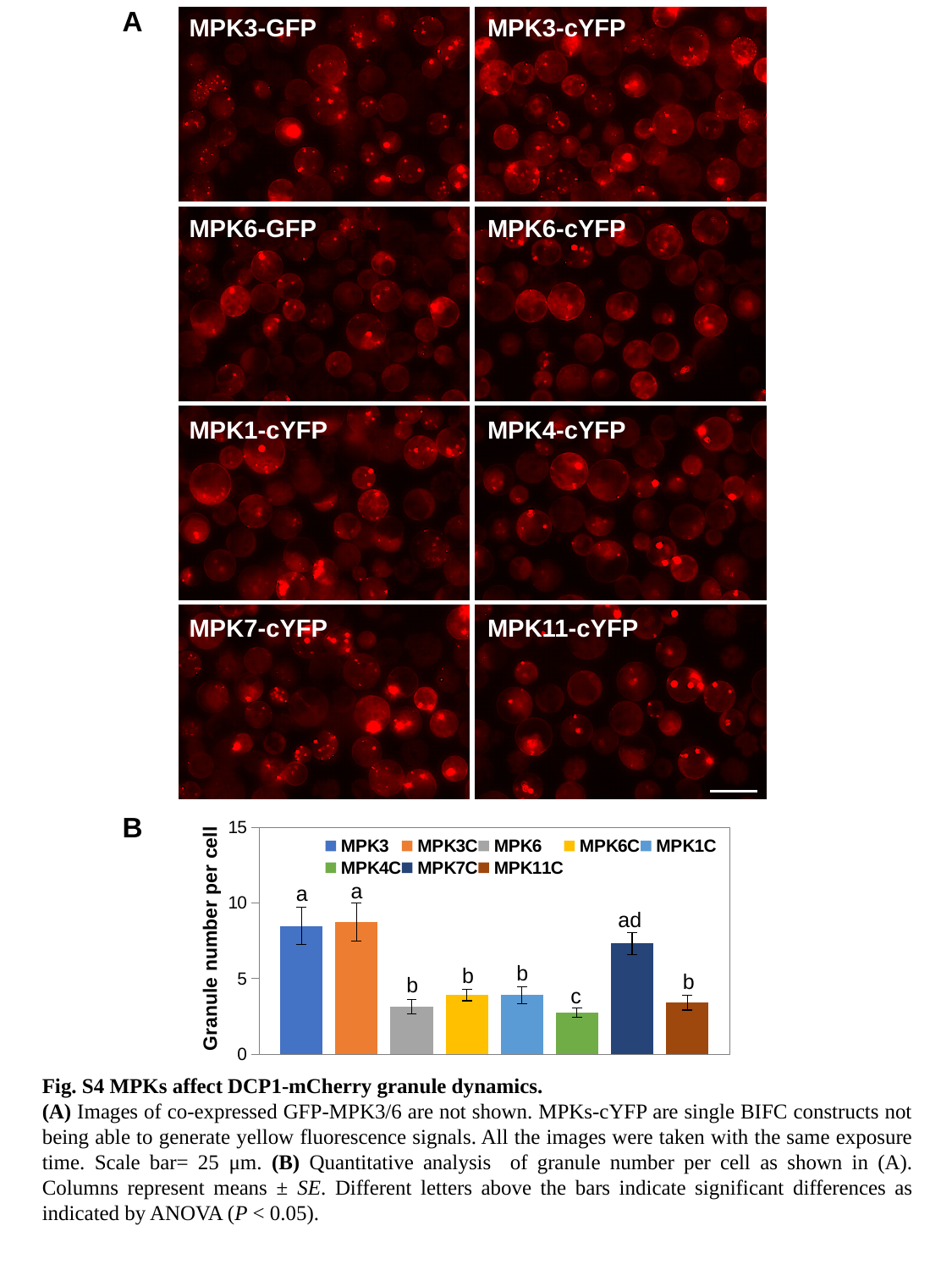
In the chart in panel B, which is larger, the value for MPK3 or the value for MPK6? MPK3 In the chart in panel B, is the value for MPK3C greater or less than 10? less In the chart in panel B, is the value for MPK4C greater or less than 5? less What is the y-axis title of the chart in panel B? Granule number per cell In the chart in panel B, what letters appear above the MPK7C bar? ad In the chart in panel B, is the value for MPK6 greater or less than 5? less What kind of chart is shown in panel B? bar chart In the chart in panel B, which is larger, the value for MPK7C or the value for MPK11C? MPK7C In the chart in panel B, which is larger, the value for MPK4C or the value for MPK3C? MPK3C How many series does the legend of the chart in panel B list? 8